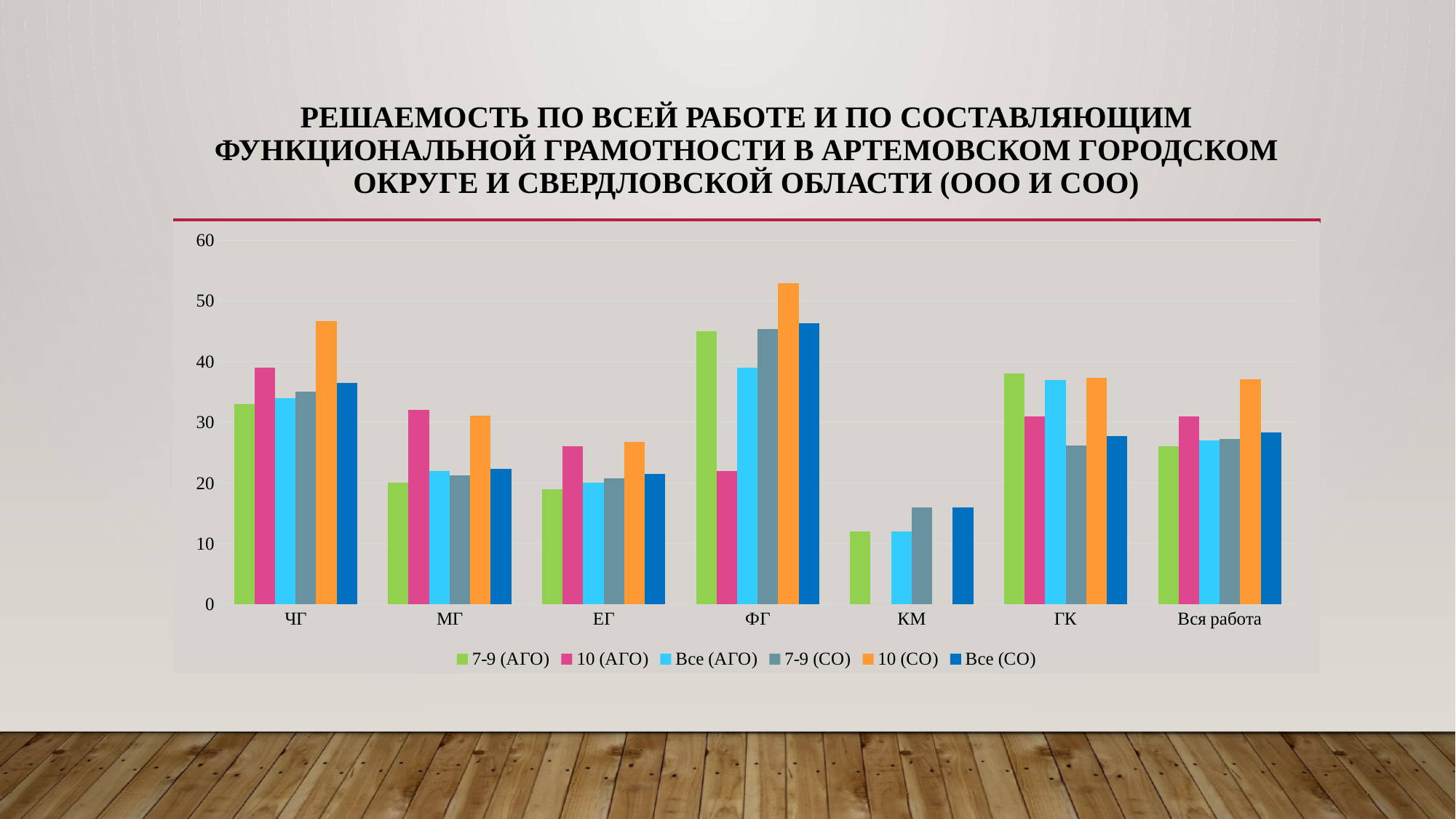
Is the value for 10 (АГО) in the ЧГ category greater or less than 30? greater How many series does the legend list? 6 How many categories are shown on the x axis? 7 What kind of chart is shown on the slide? bar chart In the ЧГ category, which is larger: 10 (СО) or 7-9 (АГО)? 10 (СО) Is the value for 10 (СО) in the ФГ category greater or less than 50? greater For the series 10 (СО), which category has the highest value? ФГ Is the value for Все (СО) in the КМ category greater or less than 20? less In the ФГ category, which is larger: 7-9 (АГО) or 10 (АГО)? 7-9 (АГО) What colour represents the series 10 (СО) in the legend? orange For the series 7-9 (АГО), which category has the lowest value? КМ